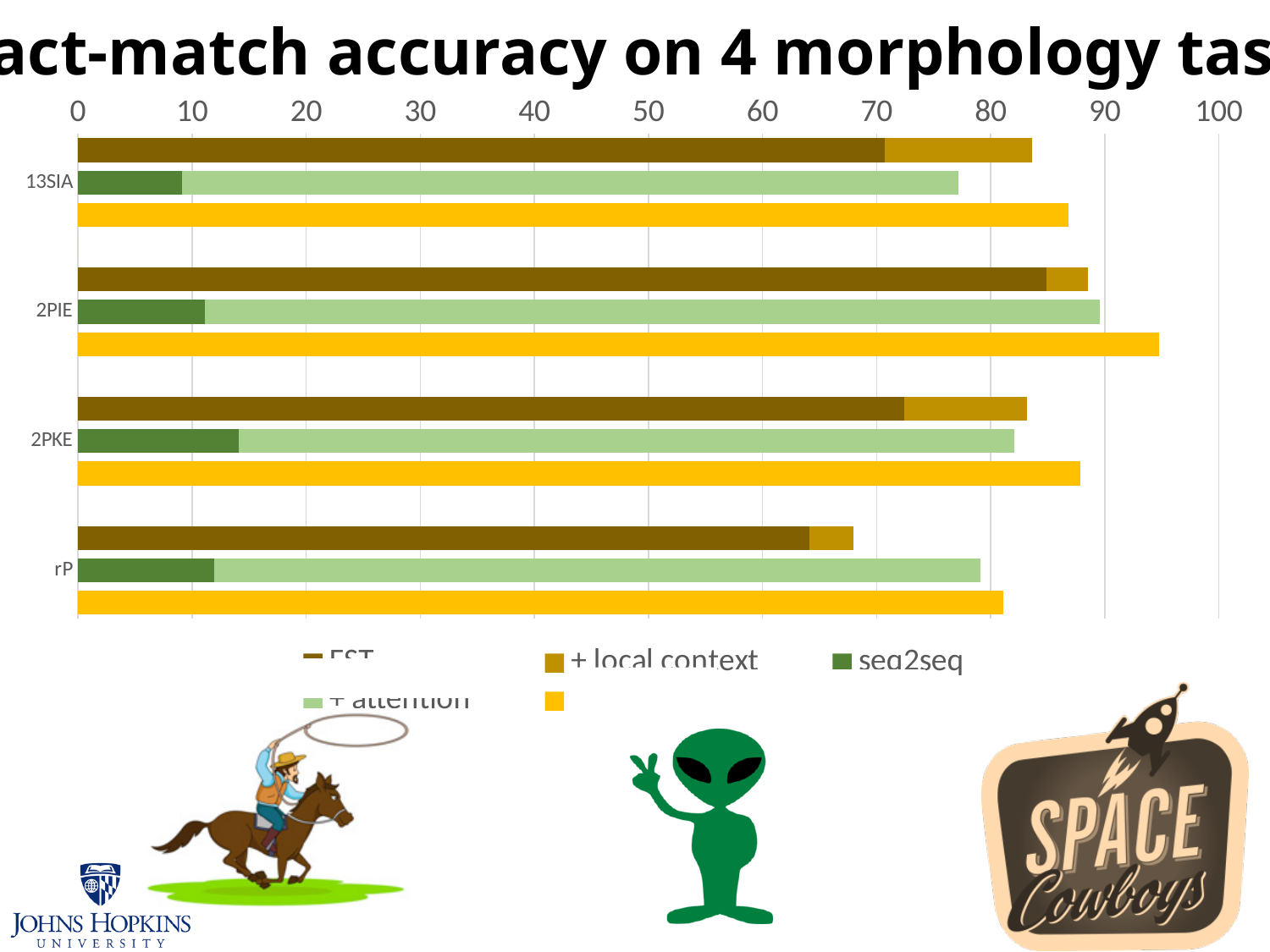
Is the FST value for rP greater or less than 60? greater Is the + attention value for rP greater or less than 80? less What kind of chart is shown on the slide? bar chart Is the + local context value for rP greater or less than 70? less Which task has the highest FST value? 2PIE Which colour represents seq2seq in the chart legend? dark green Which task has the lowest FST value? rP How many morphology tasks (categories) are shown on the y axis of the chart? 4 For 13SIA, which is larger: the seq2seq value or the + attention value? + attention